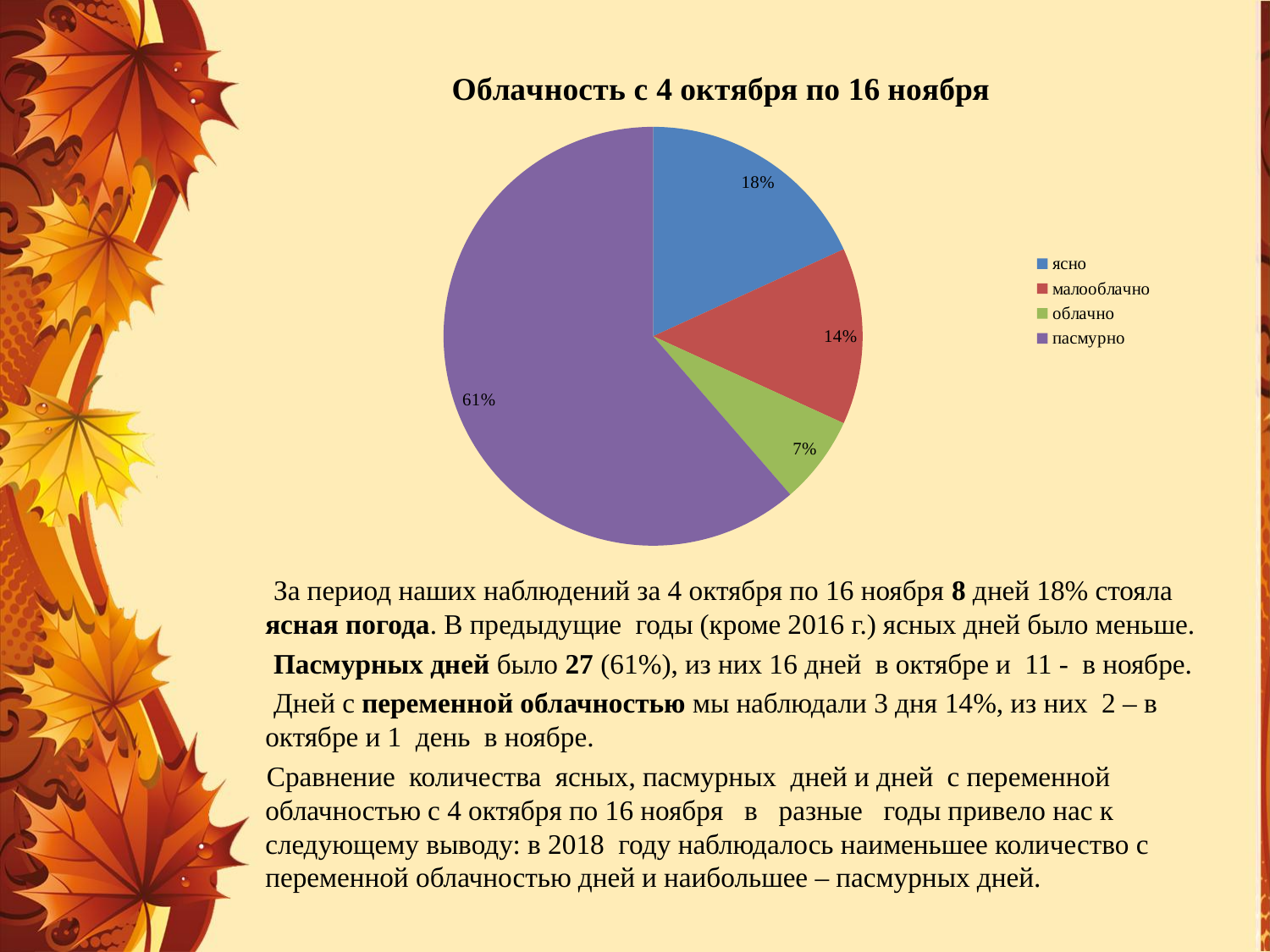
What kind of chart is shown on the slide? pie chart What share of the pie does the 'ясно' slice represent? 18% What share of the pie does the 'пасмурно' slice represent? 61% What is the title of the chart? Облачность с 4 октября по 16 ноября Which category has the smallest slice of the pie? облачно What is the difference in percentage points between the 'пасмурно' and 'ясно' slices? 43 What share of the pie does the 'облачно' slice represent? 7% Which category has the largest slice of the pie? пасмурно Which slice is larger, 'ясно' or 'малооблачно'? ясно What share of the pie does the 'малооблачно' slice represent? 14% How many categories are shown in the pie chart? 4 What colour is the 'пасмурно' slice in the pie chart? purple